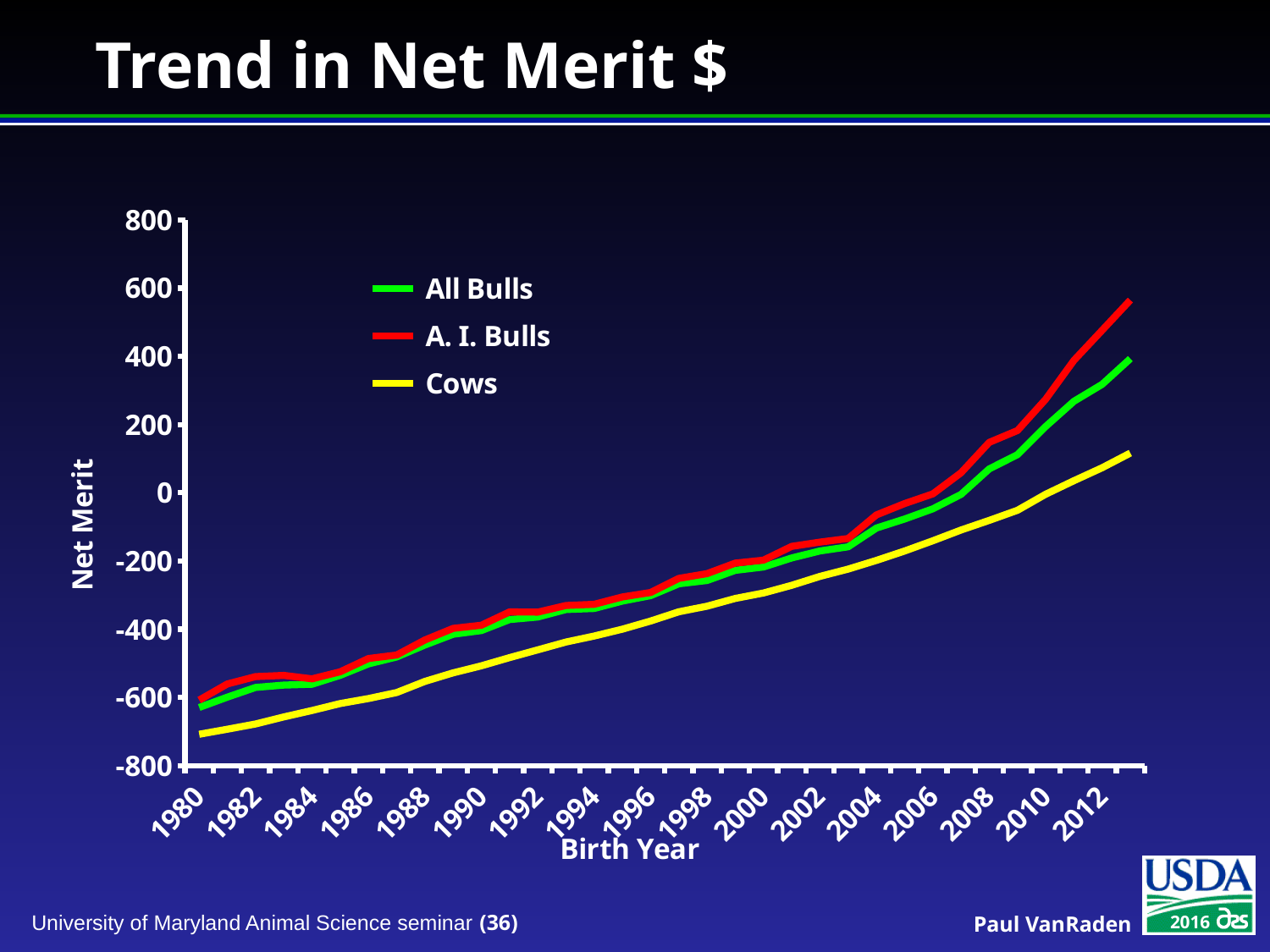
Which series has the lowest Net Merit across the birth years shown? Cows Is the Net Merit for Cows in 2000 greater or less than -200? less Is the Net Merit for All Bulls in 2012 greater or less than 200? greater How many series does the legend list? 3 Is the Net Merit for Cows in 1980 greater or less than -600? less Do the Net Merit values for A. I. Bulls rise or fall as birth year increases? rise What kind of chart is shown on the slide? line chart In 2012, which is larger: the Net Merit for A. I. Bulls or for Cows? A. I. Bulls What is the label of the x axis? Birth Year What is the title of the chart? Trend in Net Merit $ Which series has the highest Net Merit at the right end of the chart (2012)? A. I. Bulls